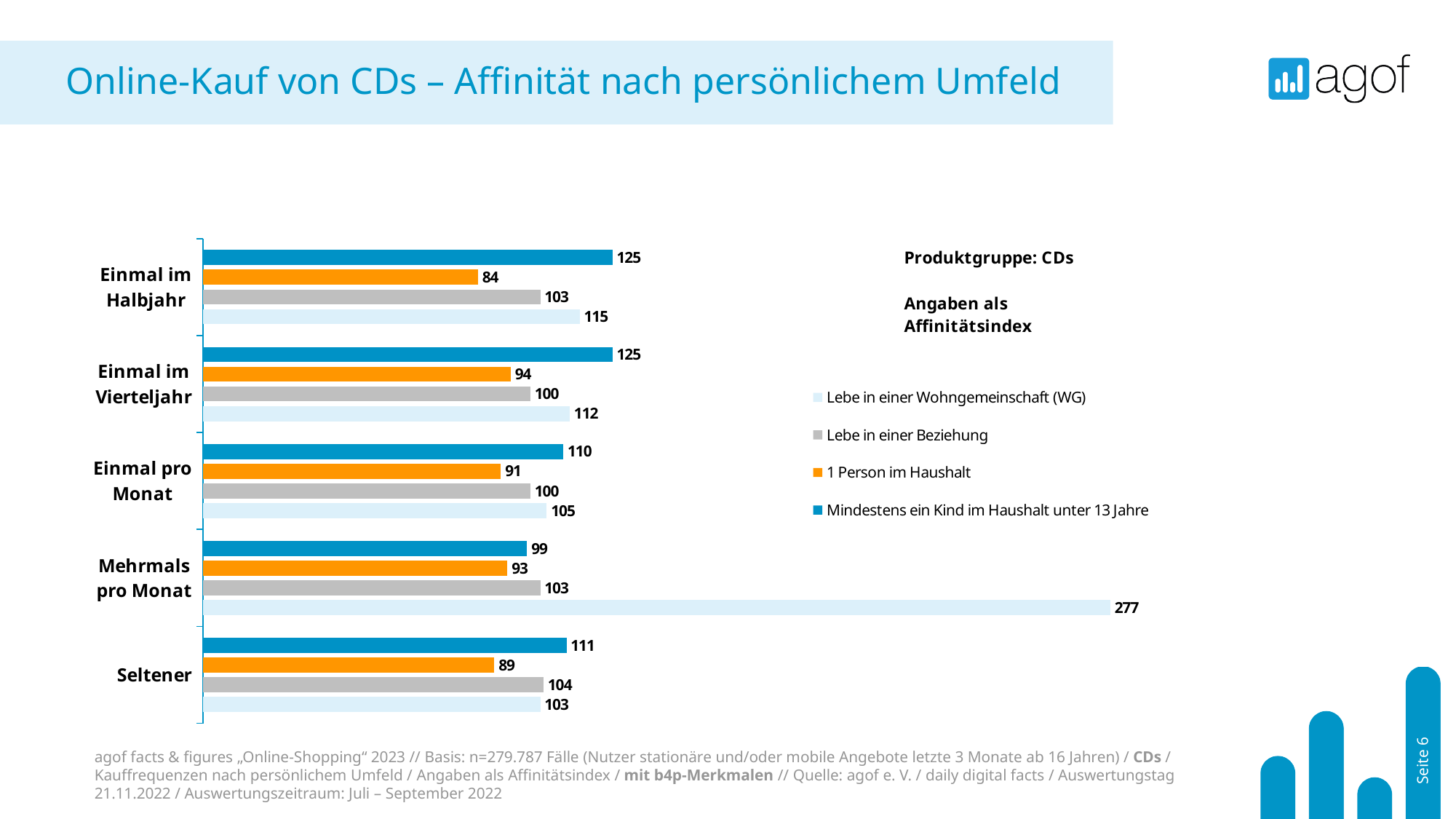
How many categories are shown on the chart? 5 What is the difference between the 'Mindestens ein Kind im Haushalt unter 13 Jahre' value and the '1 Person im Haushalt' value in the 'Einmal im Vierteljahr' category? 31 What is the value for '1 Person im Haushalt' in the 'Seltener' category? 89 What is the value for 'Lebe in einer Wohngemeinschaft (WG)' in the 'Mehrmals pro Monat' category? 277 Which category has the highest value for 'Lebe in einer Wohngemeinschaft (WG)'? Mehrmals pro Monat What is the title of the slide? Online-Kauf von CDs – Affinität nach persönlichem Umfeld What kind of chart is shown on the slide? Bar chart How many series does the legend list? 4 What is the affinity index for 'Mindestens ein Kind im Haushalt unter 13 Jahre' in the 'Einmal im Halbjahr' category? 125 Which category has the lowest value for '1 Person im Haushalt'? Einmal im Halbjahr What is the value for 'Lebe in einer Beziehung' in the 'Einmal pro Monat' category? 100 In the 'Seltener' category, which is larger: the value for 'Lebe in einer Beziehung' or for 'Lebe in einer Wohngemeinschaft (WG)'? Lebe in einer Beziehung